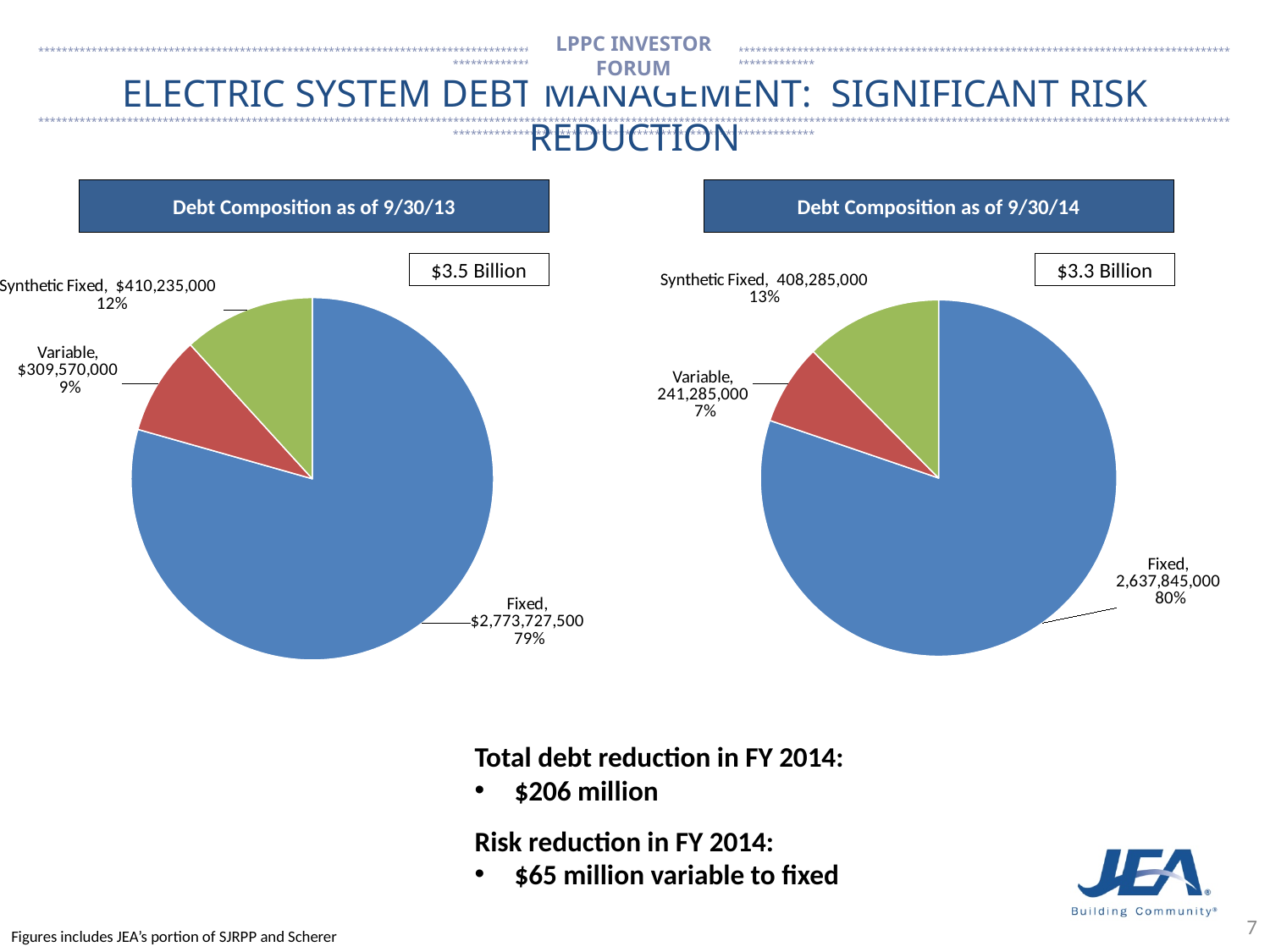
How many categories does the 'Debt Composition as of 9/30/13' chart show? 3 In the 'Debt Composition as of 9/30/13' chart, which is larger, Synthetic Fixed or Variable? Synthetic Fixed In the 'Debt Composition as of 9/30/13' chart, what is the value for Variable? $309,570,000 What kind of chart is 'Debt Composition as of 9/30/14'? Pie chart In the 'Debt Composition as of 9/30/14' chart, what share of the pie is Synthetic Fixed? 13% In the 'Debt Composition as of 9/30/14' chart, what is the difference between the Synthetic Fixed and Variable values? 167,000,000 In the 'Debt Composition as of 9/30/13' chart, what share of the pie is Fixed? 79% In the 'Debt Composition as of 9/30/13' chart, what is the value for Synthetic Fixed? $410,235,000 In the 'Debt Composition as of 9/30/14' chart, what is the value for Variable? 241,285,000 In the 'Debt Composition as of 9/30/14' chart, what is the value for Fixed? 2,637,845,000 In the 'Debt Composition as of 9/30/14' chart, which category is the smallest? Variable In the 'Debt Composition as of 9/30/13' chart, which category is the largest? Fixed